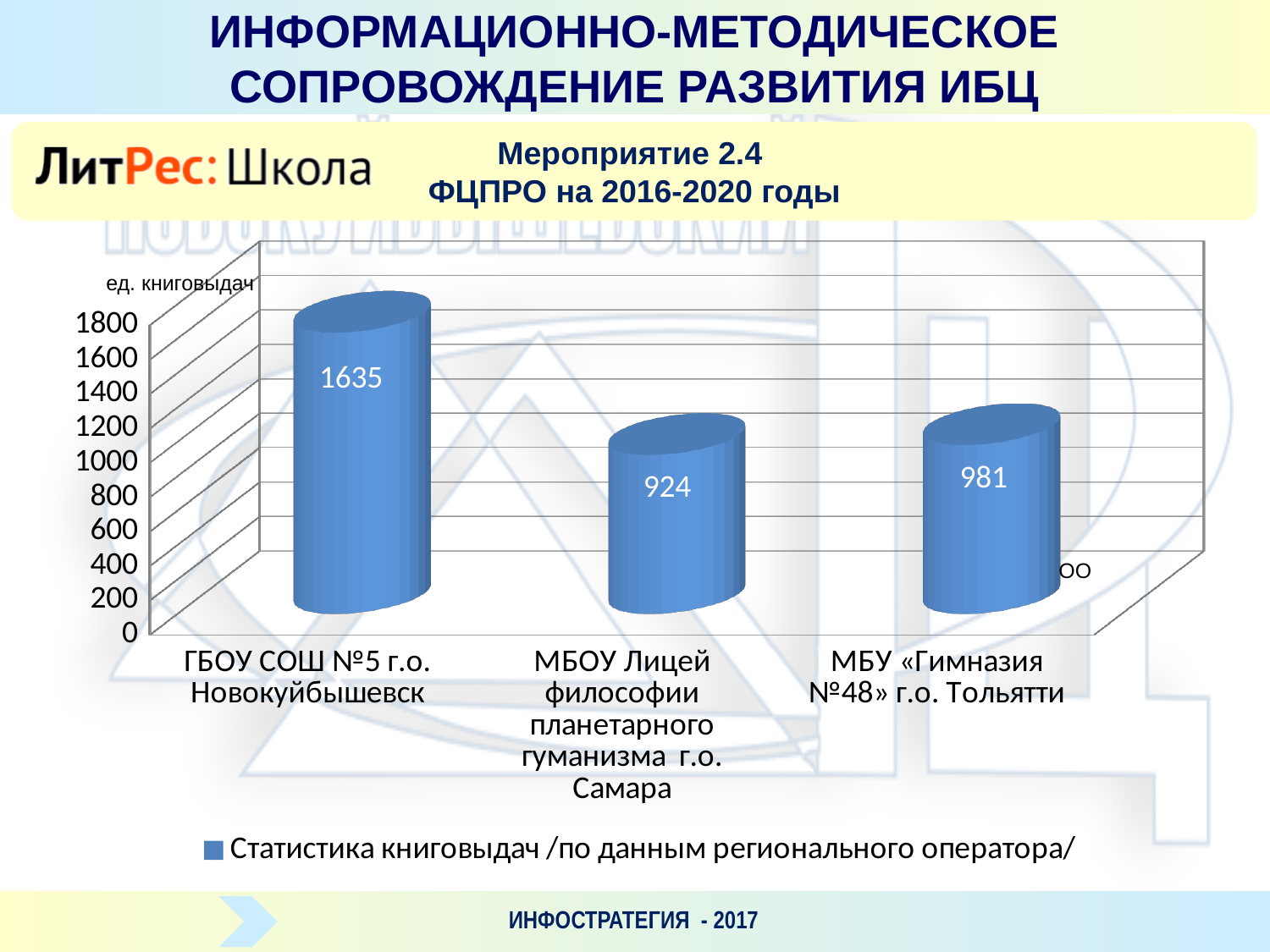
What is the difference between the values for МБУ «Гимназия №48» г.о. Тольятти and МБОУ Лицей философии планетарного гуманизма г.о. Самара? 57 Which is larger: the value for МБУ «Гимназия №48» г.о. Тольятти or the value for МБОУ Лицей философии планетарного гуманизма г.о. Самара? МБУ «Гимназия №48» г.о. Тольятти How many categories are shown on the chart? 3 What is the value for МБУ «Гимназия №48» г.о. Тольятти? 981 What kind of chart is shown on the slide? bar chart What is the value for ГБОУ СОШ №5 г.о. Новокуйбышевск? 1635 What is the legend entry of the chart? Статистика книговыдач /по данным регионального оператора/ Which category has the highest value? ГБОУ СОШ №5 г.о. Новокуйбышевск Which category has the lowest value? МБОУ Лицей философии планетарного гуманизма г.о. Самара Is the value for ГБОУ СОШ №5 г.о. Новокуйбышевск greater or less than 1400? greater What is the difference between the values for ГБОУ СОШ №5 г.о. Новокуйбышевск and МБУ «Гимназия №48» г.о. Тольятти? 654 What is the value for МБОУ Лицей философии планетарного гуманизма г.о. Самара? 924